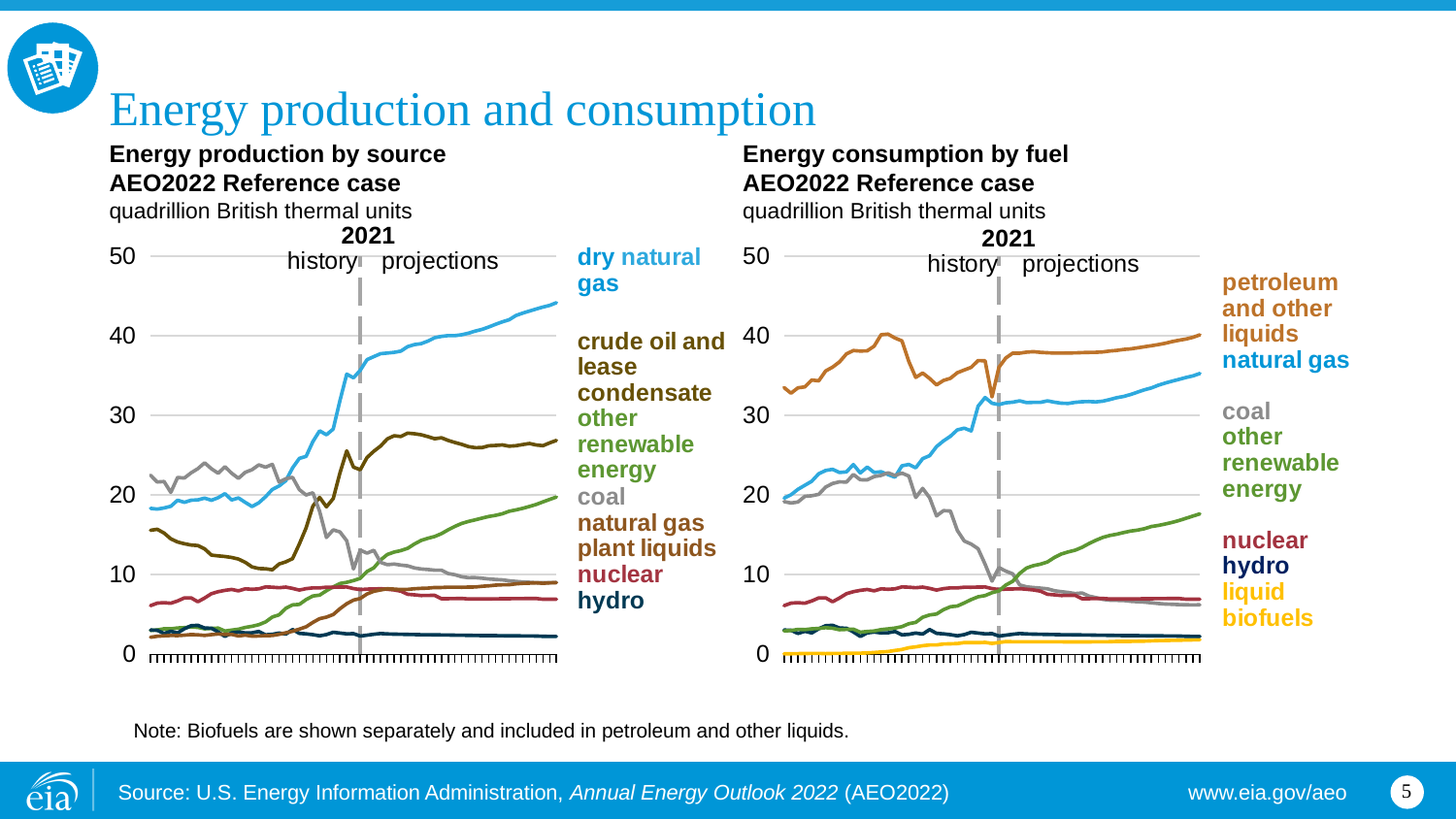
What unit is used on the y axis of both charts? quadrillion British thermal units In the 'Energy consumption by fuel' chart, which fuel has the lowest value at the end of the projection period? liquid biofuels In the 'Energy production by source' chart, is the value for dry natural gas at the end of the projection period greater or less than 40? greater In the 'Energy production by source' chart, which source has the highest value at the end of the projection period? dry natural gas How many series does the legend of the 'Energy production by source' chart list? 7 How many series does the legend of the 'Energy consumption by fuel' chart list? 7 In the 'Energy production by source' chart, is the value for crude oil and lease condensate at the end of the projection period greater or less than 30? less In the 'Energy production by source' chart, which source has the lowest value at the end of the projection period? hydro In the 'Energy consumption by fuel' chart, is the value for natural gas at the end of the projection period greater or less than 30? greater In the 'Energy consumption by fuel' chart, does coal consumption rise or fall over the projection period? fall In the 'Energy consumption by fuel' chart, which fuel has the highest value at the end of the projection period? petroleum and other liquids What kind of chart is the 'Energy production by source' chart on the left? line chart